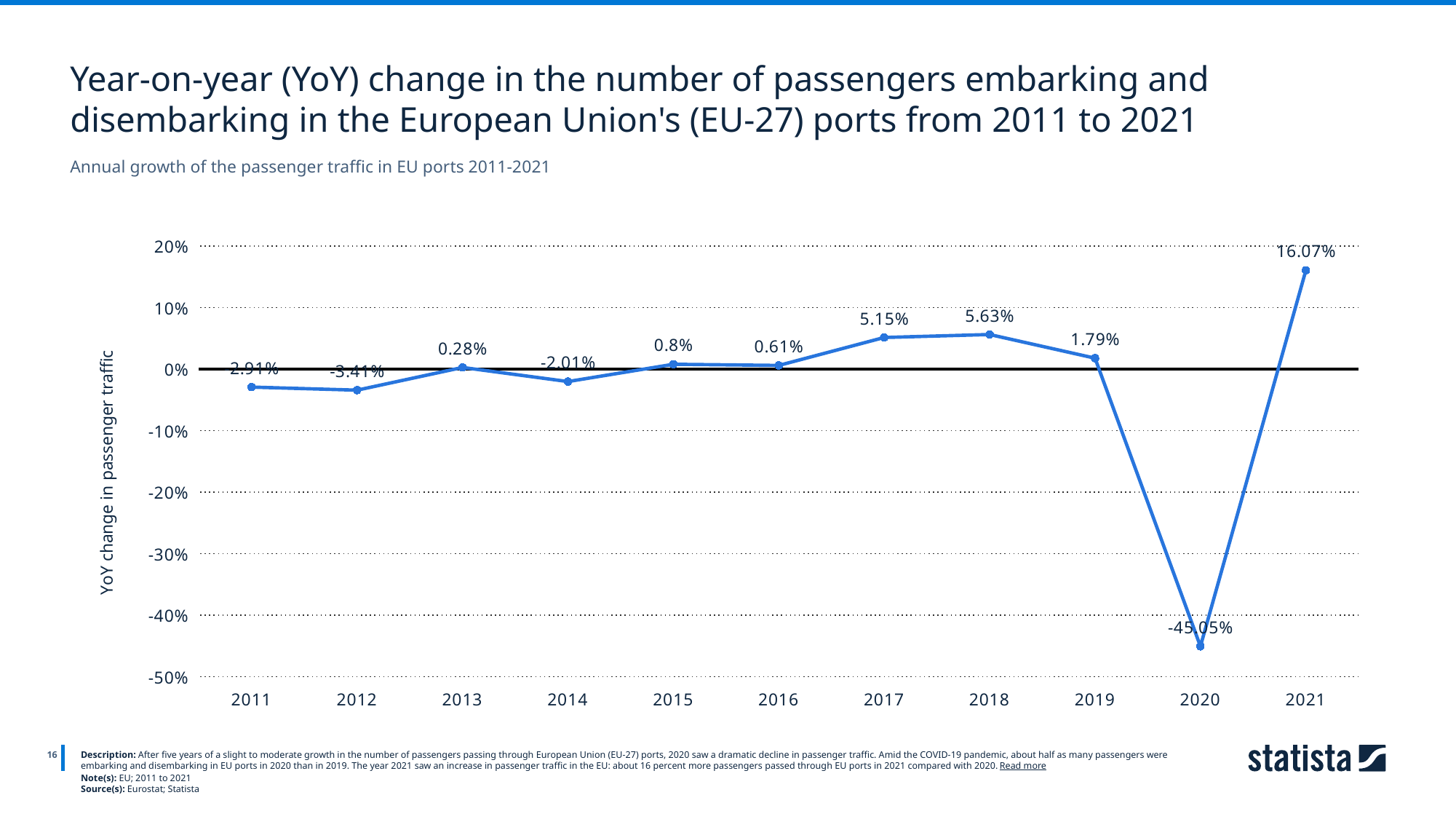
Is the YoY change for 2020 greater or less than -40%? less How many years are plotted on the chart? 11 Which year has the highest YoY change in passenger traffic? 2021 Which year has the lowest YoY change in passenger traffic? 2020 What is the YoY change in passenger traffic in EU ports for 2021? 16.07% Does the YoY change rise or fall from 2019 to 2020? fall What is the YoY change in passenger traffic in EU ports for 2020? -45.05% What is the YoY change in passenger traffic in EU ports for 2014? -2.01% Which year has the larger YoY change: 2017 or 2019? 2017 What is the difference between the YoY change in 2018 and in 2017? 0.48% What is the YoY change in passenger traffic in EU ports for 2018? 5.63% What type of chart is shown on the slide? line chart